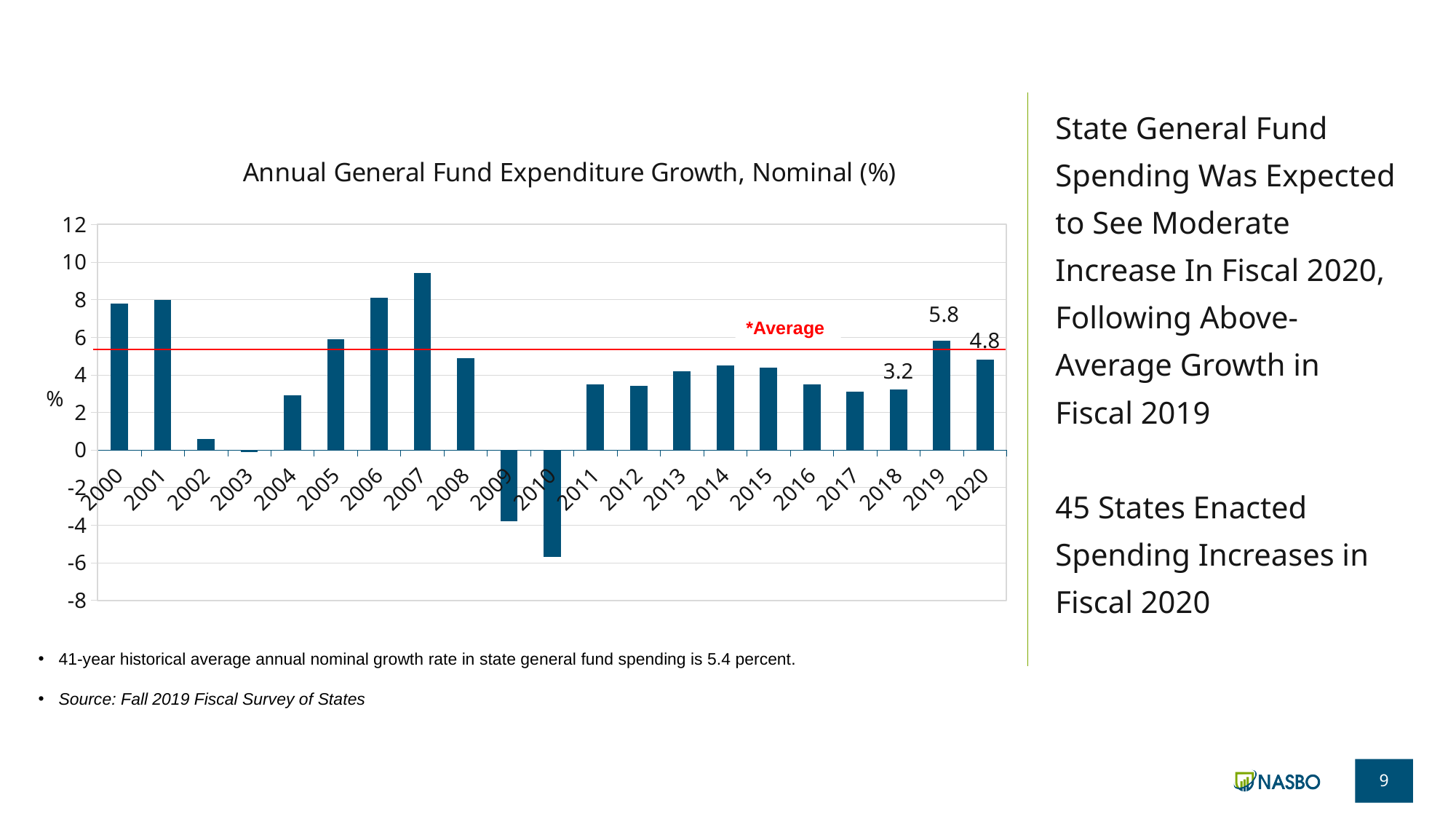
Which year has the highest general fund expenditure growth in the chart? 2007 What is the difference between the values for 2019 and 2018? 2.6 What kind of chart is shown on the slide? bar chart What is the value for 2020 in the chart? 4.8 Is the value for 2007 greater or less than 8? greater Which year has the lowest general fund expenditure growth in the chart? 2010 How many years are shown on the x axis of the chart? 21 What is the difference between the values for 2019 and 2020? 1.0 Is the value for 2010 greater or less than -4? less Which year has the larger value, 2019 or 2020? 2019 What is the value for 2018 in the chart? 3.2 What is the value for 2019 in the Annual General Fund Expenditure Growth chart? 5.8